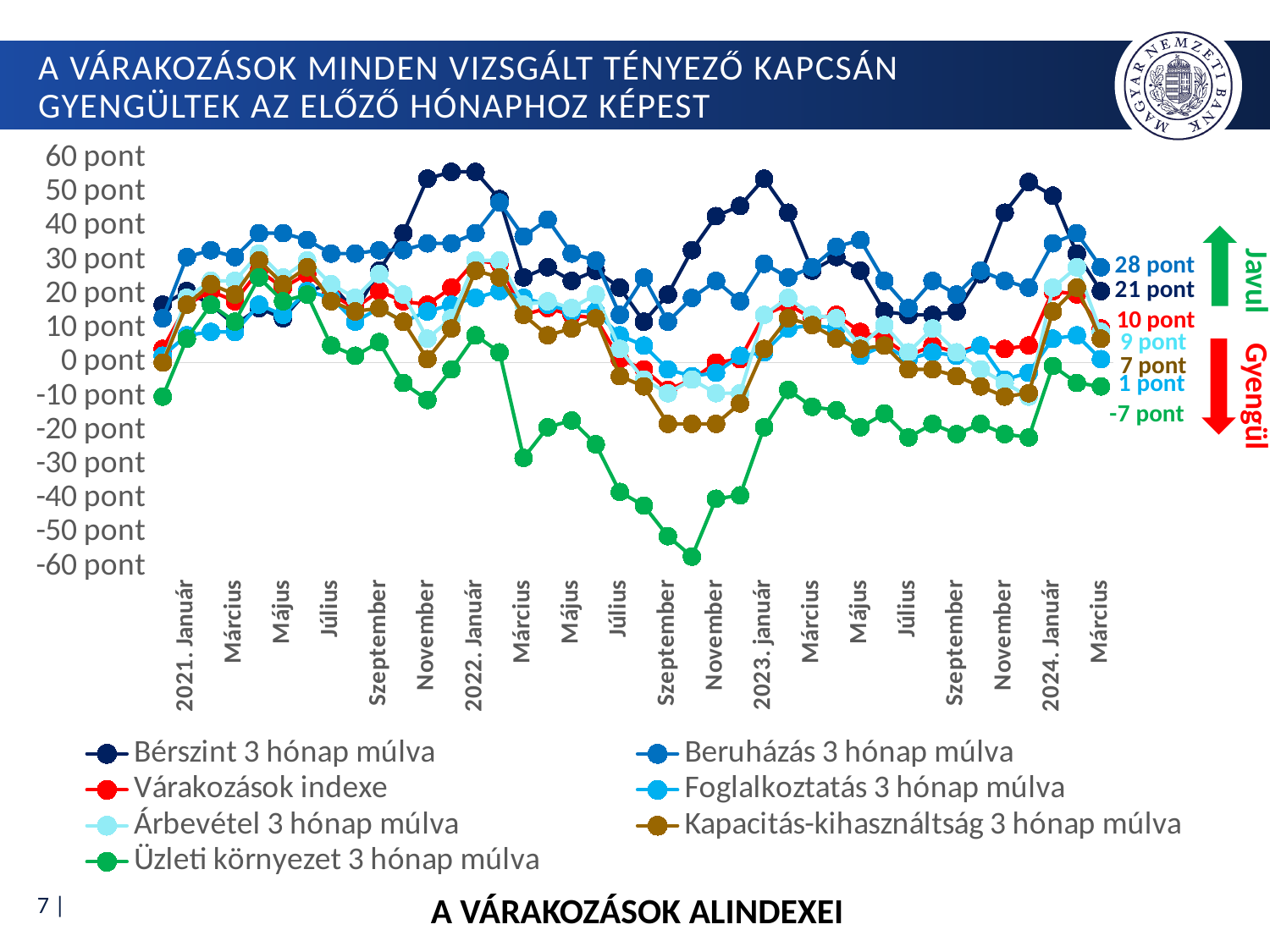
Which has the larger latest labelled value, Árbevétel 3 hónap múlva or Kapacitás-kihasználtság 3 hónap múlva? Árbevétel 3 hónap múlva What is the latest labelled value for Üzleti környezet 3 hónap múlva? -7 pont What is the latest labelled value for Várakozások indexe? 10 pont How many series does the legend list? 7 What is the difference between the latest labelled values of Beruházás 3 hónap múlva and Bérszint 3 hónap múlva? 7 pont What is the latest labelled value for Foglalkoztatás 3 hónap múlva? 1 pont What is the latest labelled value for Bérszint 3 hónap múlva? 21 pont Which series has the highest latest labelled value? Beruházás 3 hónap múlva What is the latest labelled value for Beruházás 3 hónap múlva? 28 pont What kind of chart is shown on the slide? line chart Which series has the lowest latest labelled value? Üzleti környezet 3 hónap múlva